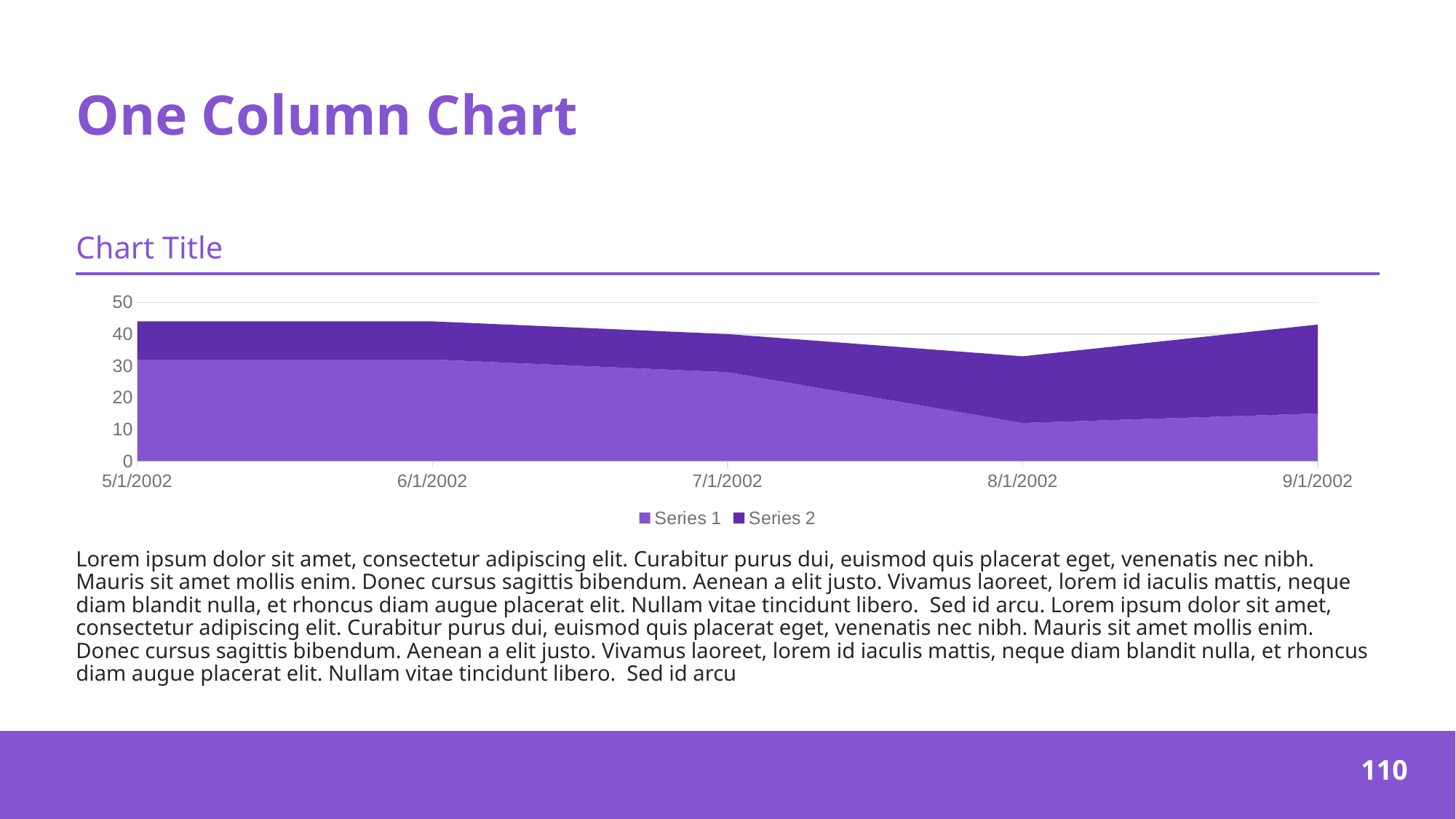
Is the stacked total at 5/1/2002 greater or less than 40? greater Is the value for Series 1 at 8/1/2002 greater or less than 20? less How many series does the chart's legend list? 2 At which date is the value for Series 1 lowest? 8/1/2002 What is the title shown above the chart? Chart Title How many dates are plotted along the x axis of the chart? 5 At which date is the stacked total of Series 1 and Series 2 lowest? 8/1/2002 Does the value for Series 1 rise or fall from 5/1/2002 to 8/1/2002? fall Is the stacked total at 8/1/2002 greater or less than 40? less What are the names of the series in the chart's legend? Series 1 and Series 2 What kind of chart is shown on the slide? Stacked area chart